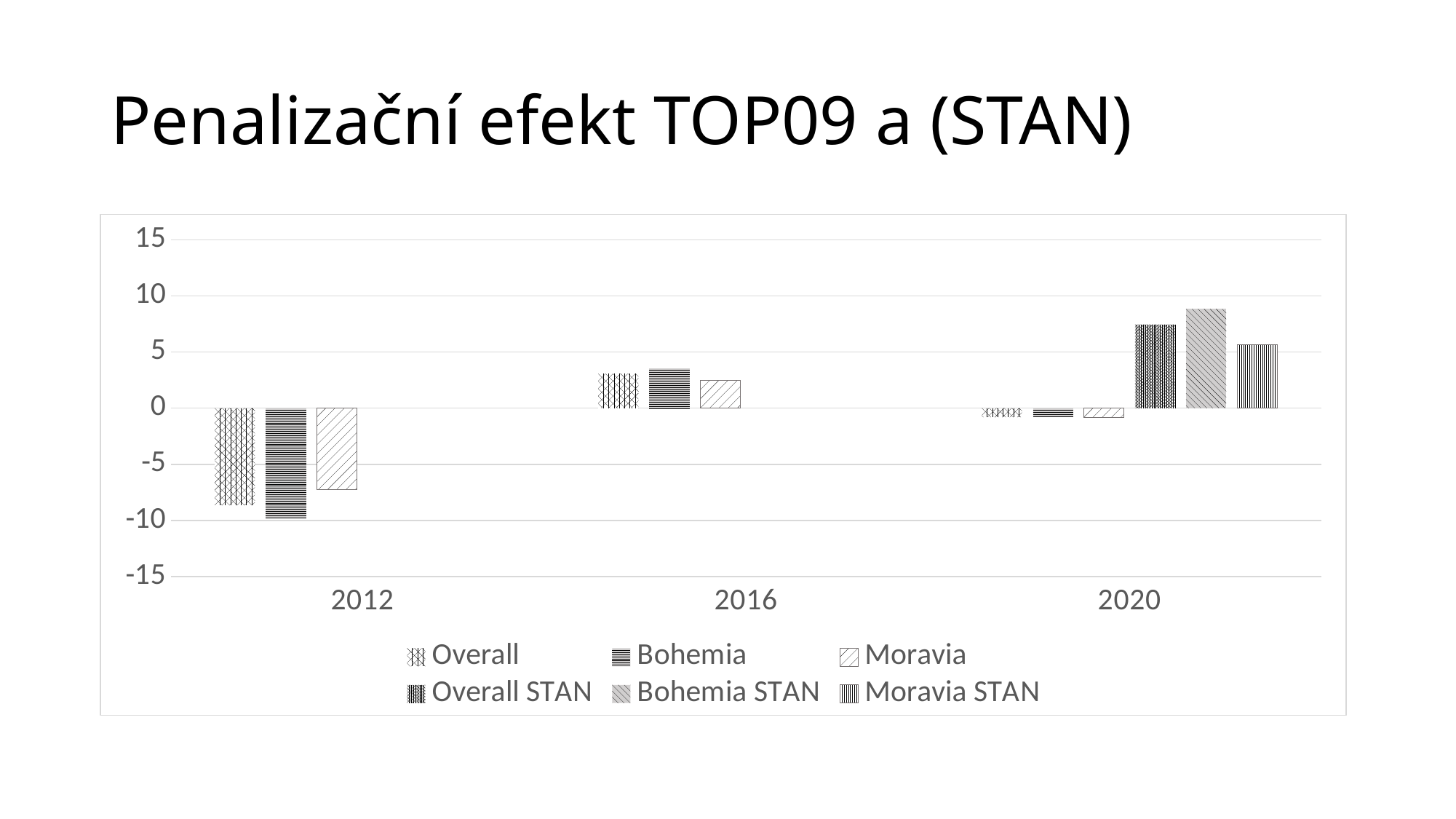
Which series has the lowest value in 2012? Bohemia What kind of chart is shown on the slide? bar chart Is the value for Moravia in 2016 greater or less than 5? less What is the title of the slide? Penalizační efekt TOP09 a (STAN) In 2020, which is larger, Bohemia STAN or Moravia STAN? Bohemia STAN Does the Overall series rise or fall from 2012 to 2016? rise Is the value for Bohemia in 2012 greater or less than -5? less How many series does the legend list? 6 Which series has the highest value in 2020? Bohemia STAN Is the value for Overall STAN in 2020 greater or less than 5? greater How many years are shown on the x axis? 3